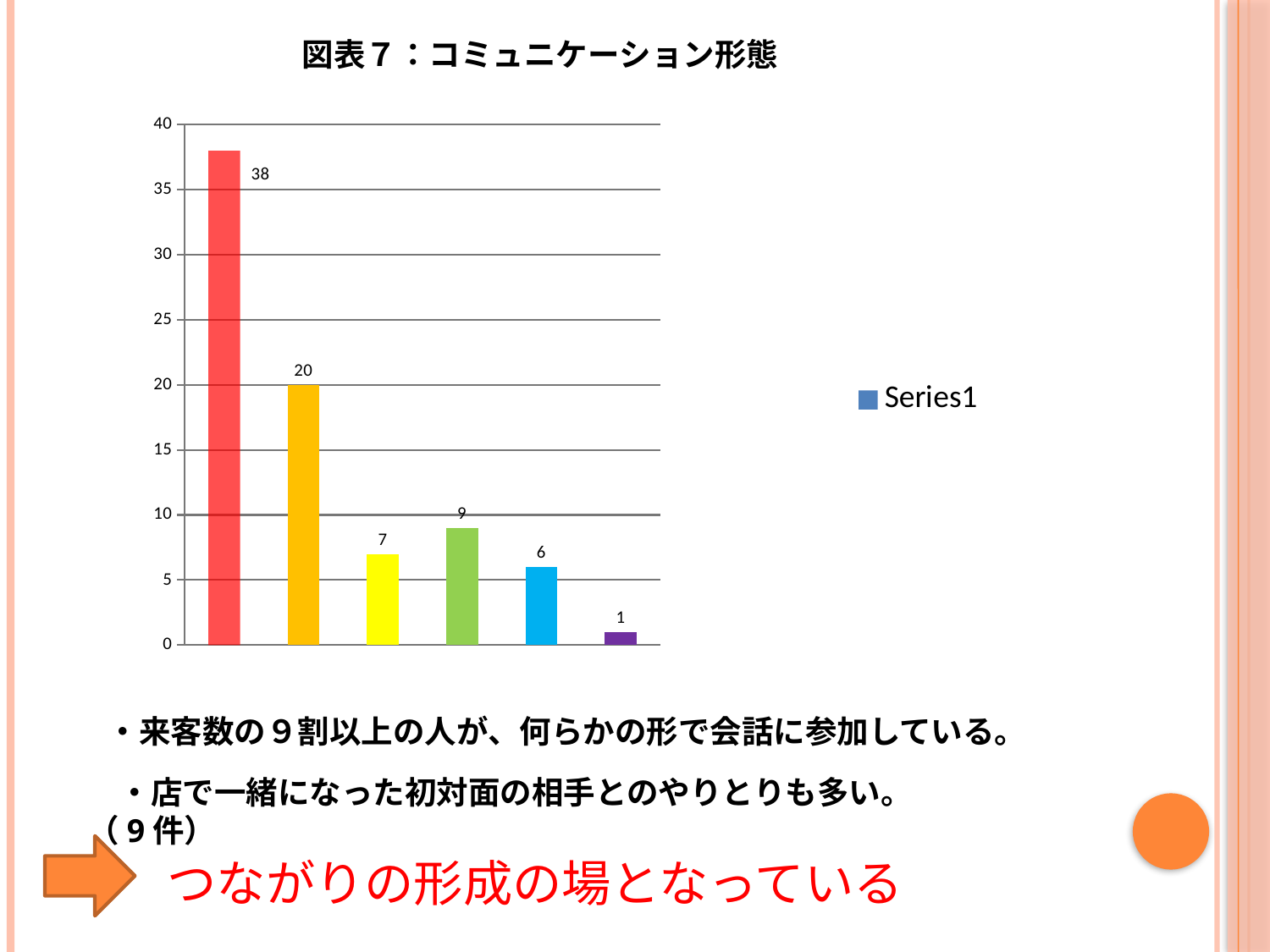
What is the difference between the red bar (38) and the orange bar (20)? 18 What kind of chart is shown on the slide? Bar chart How many bars are plotted in the chart? 6 How many series does the legend list? 1 Which bar has the lowest value? The purple (last) bar, 1 What is the value shown on the purple (last) bar? 1 What is the value shown on the orange (second) bar? 20 What is the value shown on the red (first) bar? 38 What is the value shown on the green (fourth) bar? 9 Which is larger, the yellow bar or the green bar? The green bar (9) Which bar has the highest value? The red (first) bar, 38 What is the title of the chart? 図表７：コミュニケーション形態